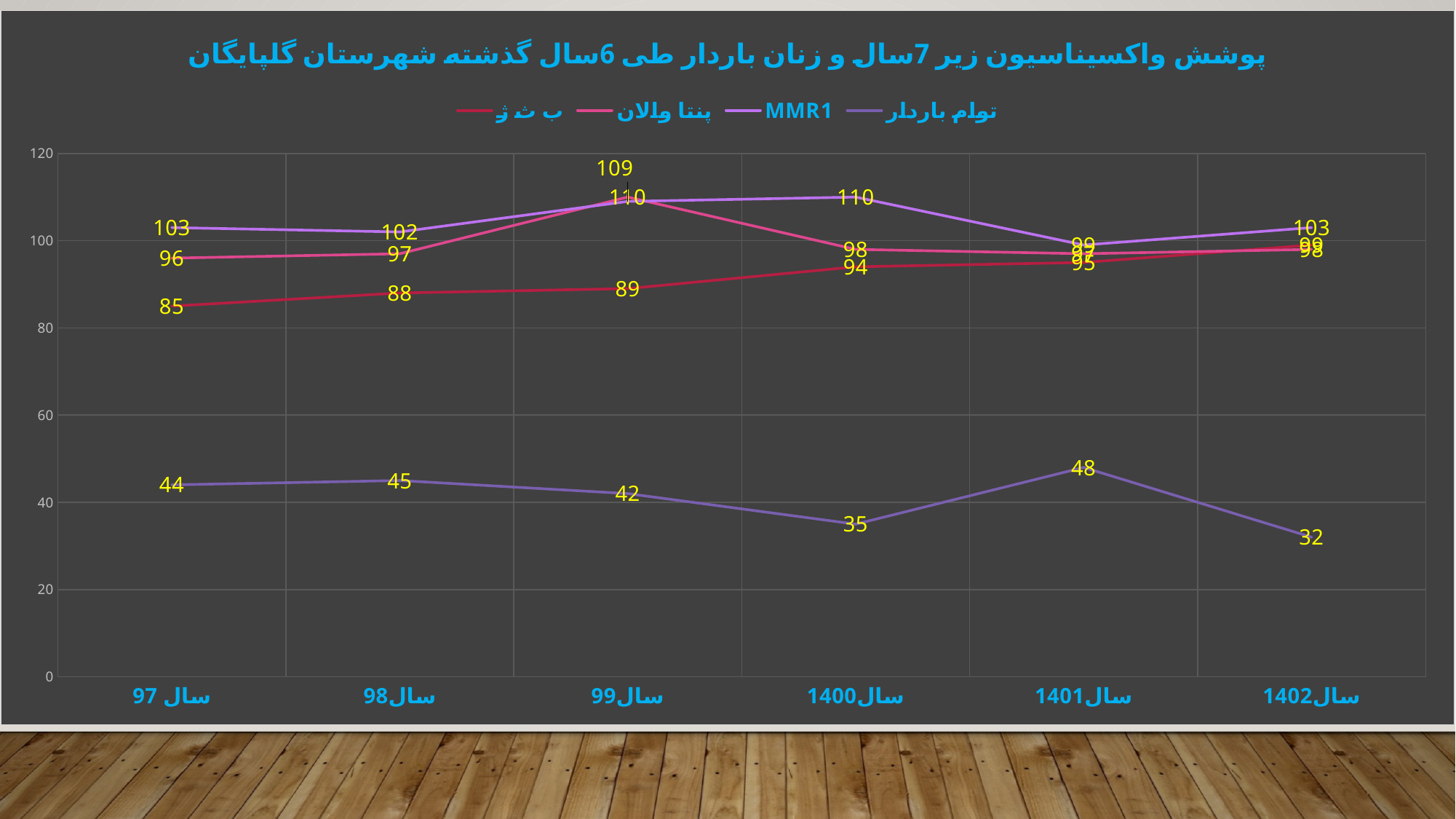
What is the difference between the ب ث ژ values in سال 1400 and سال 97? 9 In which year is the value for توام باردار lowest? سال 1402 What is the value for توام باردار in سال 1402? 32 What kind of chart is shown on the slide? line chart In which year is the value for توام باردار highest? سال 1401 How many series does the legend list? 4 What is the value for پنتا والان in سال 99? 110 In سال 98, which series has the larger value, MMR1 or توام باردار? MMR1 How many years are shown along the x axis? 6 Does the ب ث ژ series rise or fall from سال 97 to سال 1402? rises What is the value for ب ث ژ in سال 97? 85 What is the value for MMR1 in سال 1400? 110